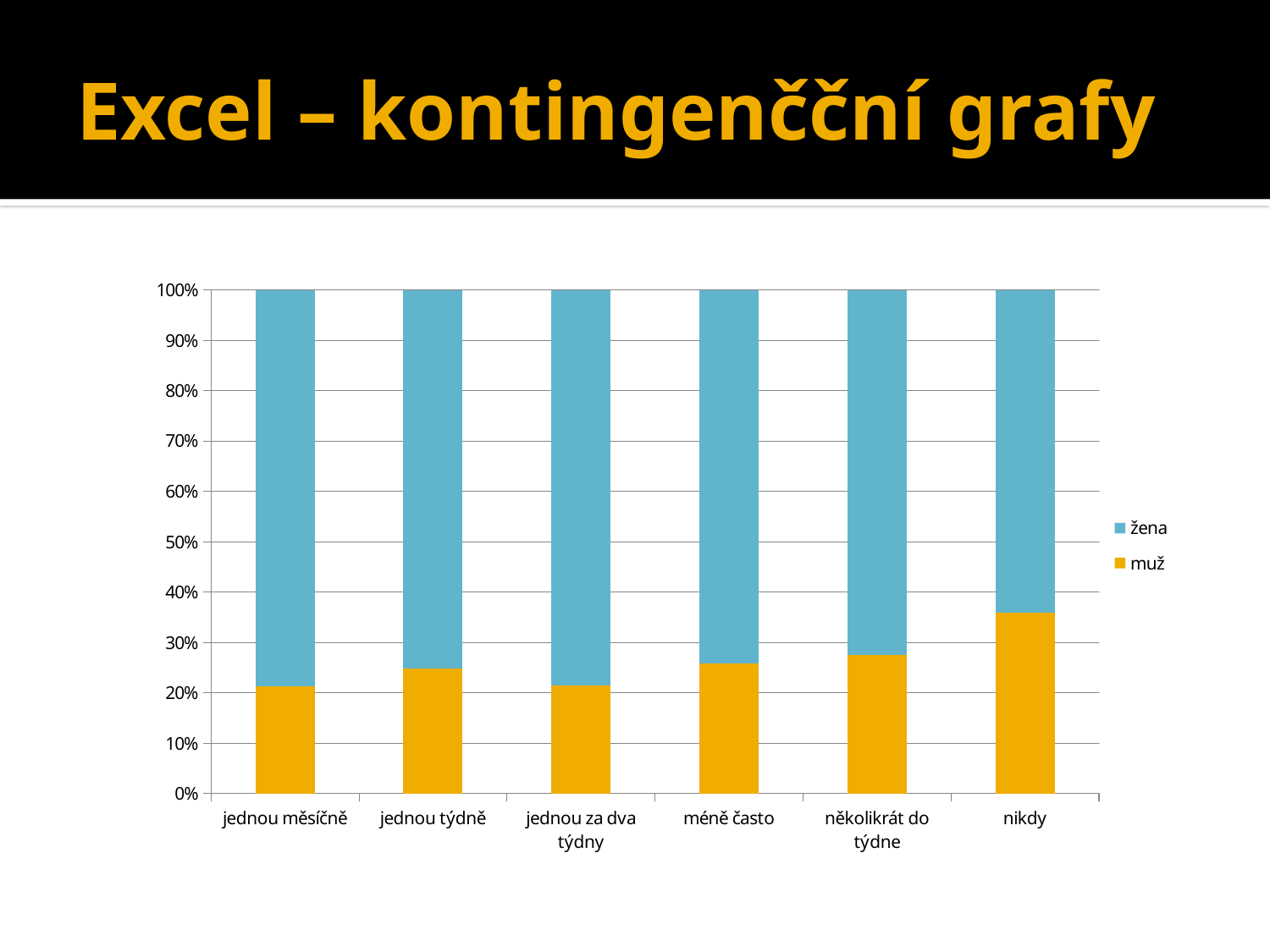
Is the žena value for nikdy greater or less than 70%? less Which is larger: the muž value for několikrát do týdne or the muž value for jednou měsíčně? několikrát do týdne Is the muž value for nikdy greater or less than 30%? greater What kind of chart is shown on the slide? stacked bar chart How many series does the chart legend list? 2 How many categories are shown on the x axis of the chart? 6 For which category is the muž share the highest? nikdy Is the žena value for jednou měsíčně greater or less than 70%? greater What is the total height of the stacked bar for nikdy? 100% Which series is shown in orange in the chart? muž Which is larger: the muž value for nikdy or the muž value for jednou měsíčně? nikdy